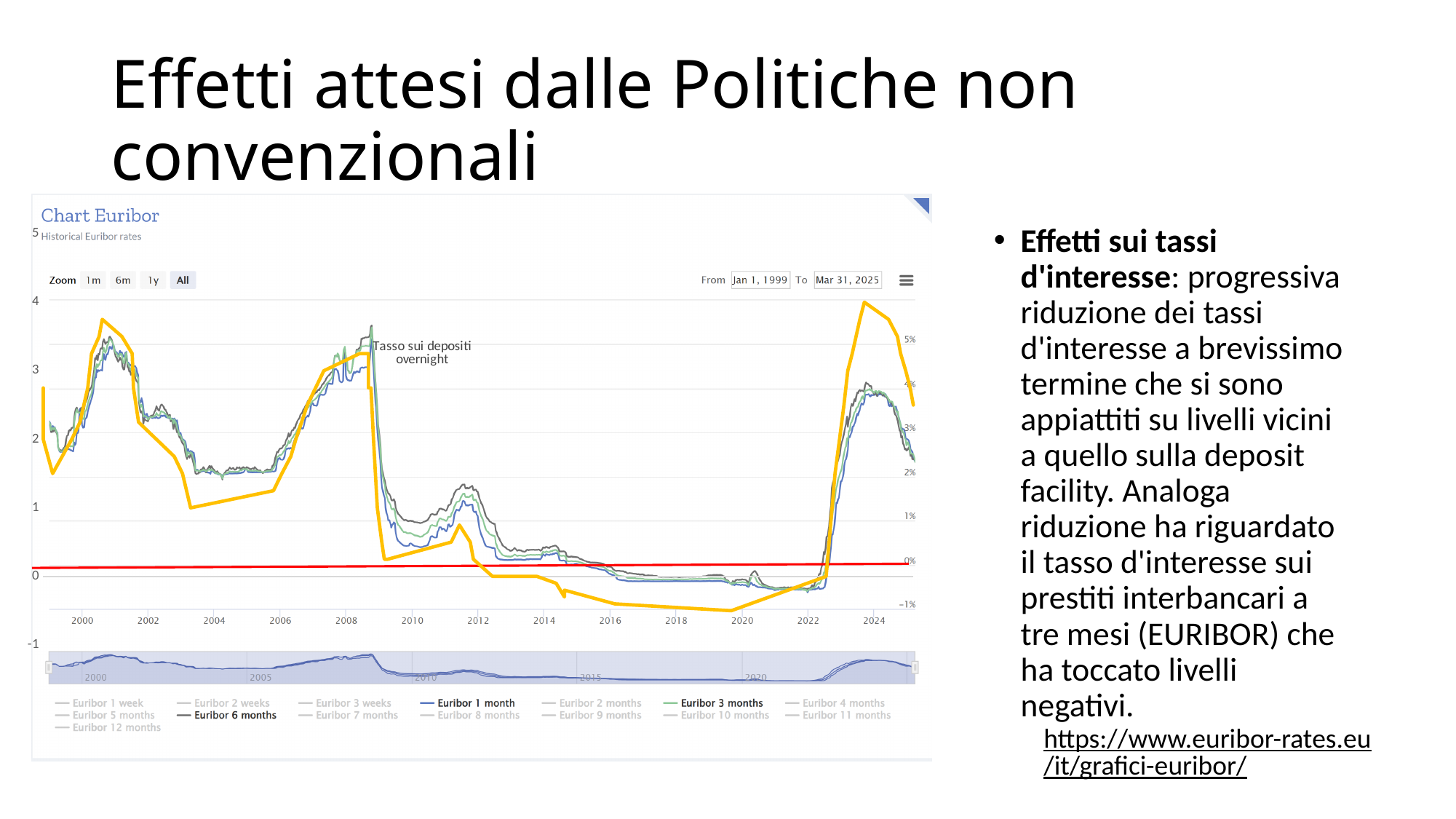
How many year labels are shown along the x axis of the main chart? 13 Around 2019, is the Euribor 3 months value greater or less than 0%? less At its 2008 peak, is the Euribor 6 months value greater or less than 4% on the right-hand axis? greater What label is written next to the yellow line on the chart? Tasso sui depositi overnight Between 2022 and 2023, do the Euribor rates rise or fall? rise Between late 2008 and 2009, do the Euribor rates rise or fall? fall Is the Euribor 6 months rate higher in 2008 or in 2012? 2008 What is the title of the chart on the slide? Chart Euribor How many Euribor series does the chart legend list? 15 Is the Euribor 1 month rate higher in 2000 or in 2004? 2000 What kind of chart is shown on the slide? line chart Around 2003, is the yellow overnight deposit rate line greater or less than 2 on the left-hand axis? less